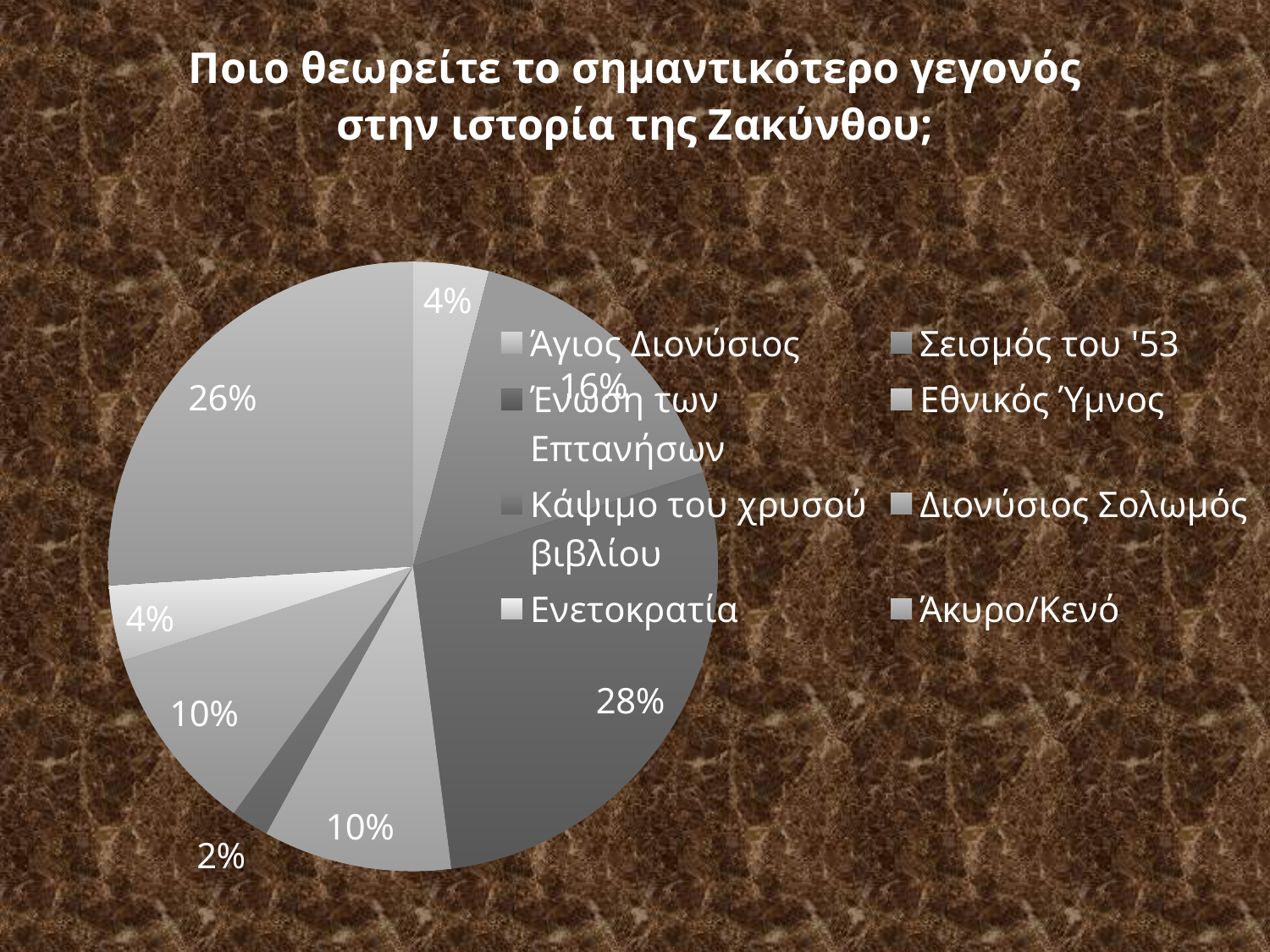
Which legend entry is listed first in the pie chart's legend? Άγιος Διονύσιος What is the combined share of the two slices labelled 28% and 26%? 54% What is the smallest percentage shown on any slice of the pie chart? 2% How many slices of the pie chart are labelled 4%? 2 What is the title of the chart? Ποιο θεωρείτε το σημαντικότερο γεγονός στην ιστορία της Ζακύνθου; What is the difference between the largest slice (28%) and the smallest slice (2%)? 26% How many slices of the pie chart are labelled 10%? 2 How many categories does the legend of the pie chart list? 8 What kind of chart is shown on the slide? pie chart Is the largest slice of the pie chart greater or less than 25%? greater Which is larger, the slice labelled 26% or the slice labelled 16%? 26% What is the largest percentage shown on any slice of the pie chart? 28%